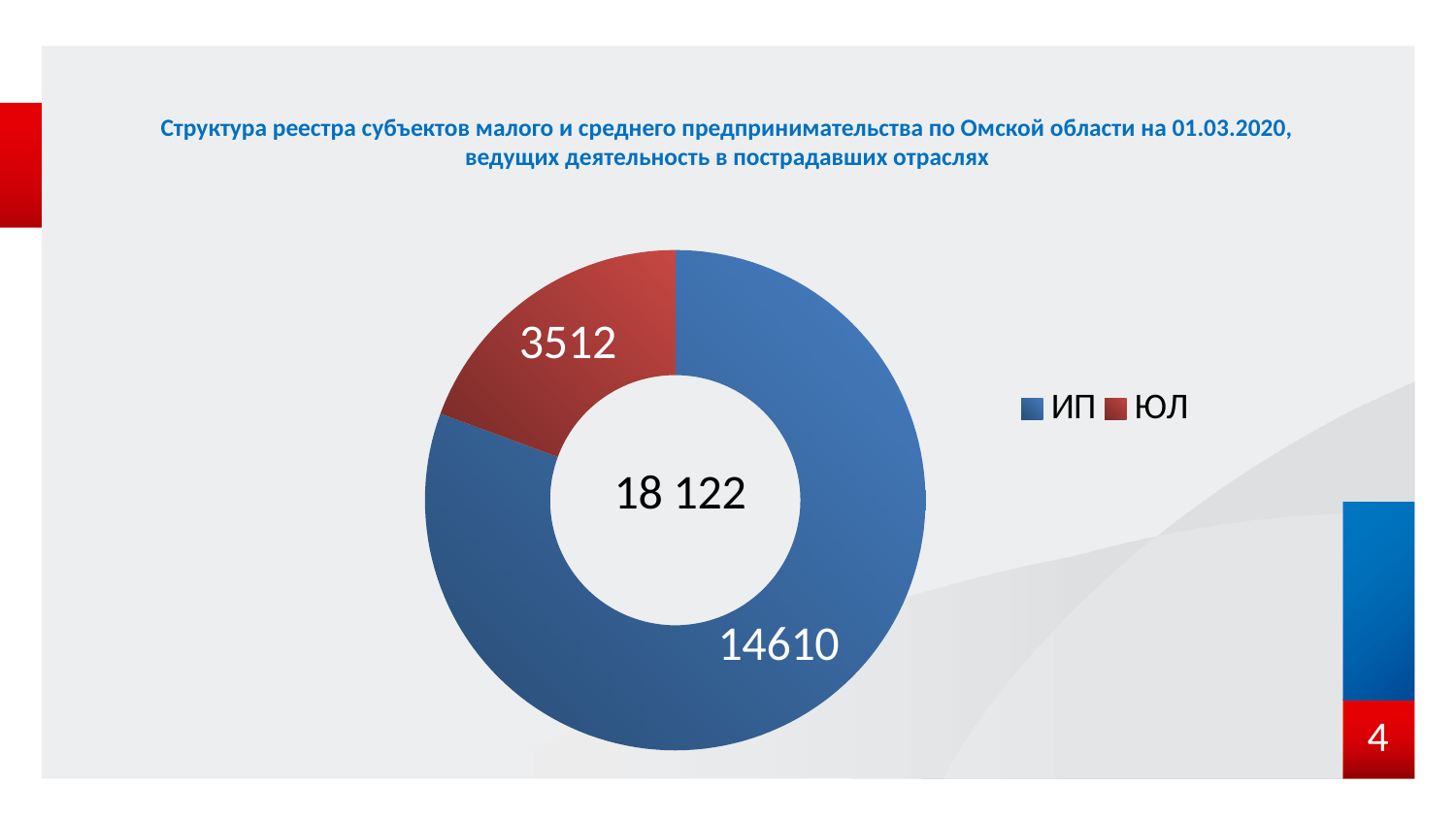
How many entries does the legend list? 2 Which category has the smallest slice in the chart? ЮЛ How many categories does the chart show? 2 What is the value for ЮЛ in the chart? 3512 What colour is the ИП slice in the chart? blue What share of the total does ЮЛ represent, to the nearest whole percent? 19% Which category has the largest slice in the chart? ИП What is the value for ИП in the chart? 14610 Which is larger, the value for ИП or the value for ЮЛ? ИП What is the difference between the values for ИП and ЮЛ? 11098 What total is printed in the centre of the chart? 18 122 What kind of chart is shown on the slide? doughnut chart